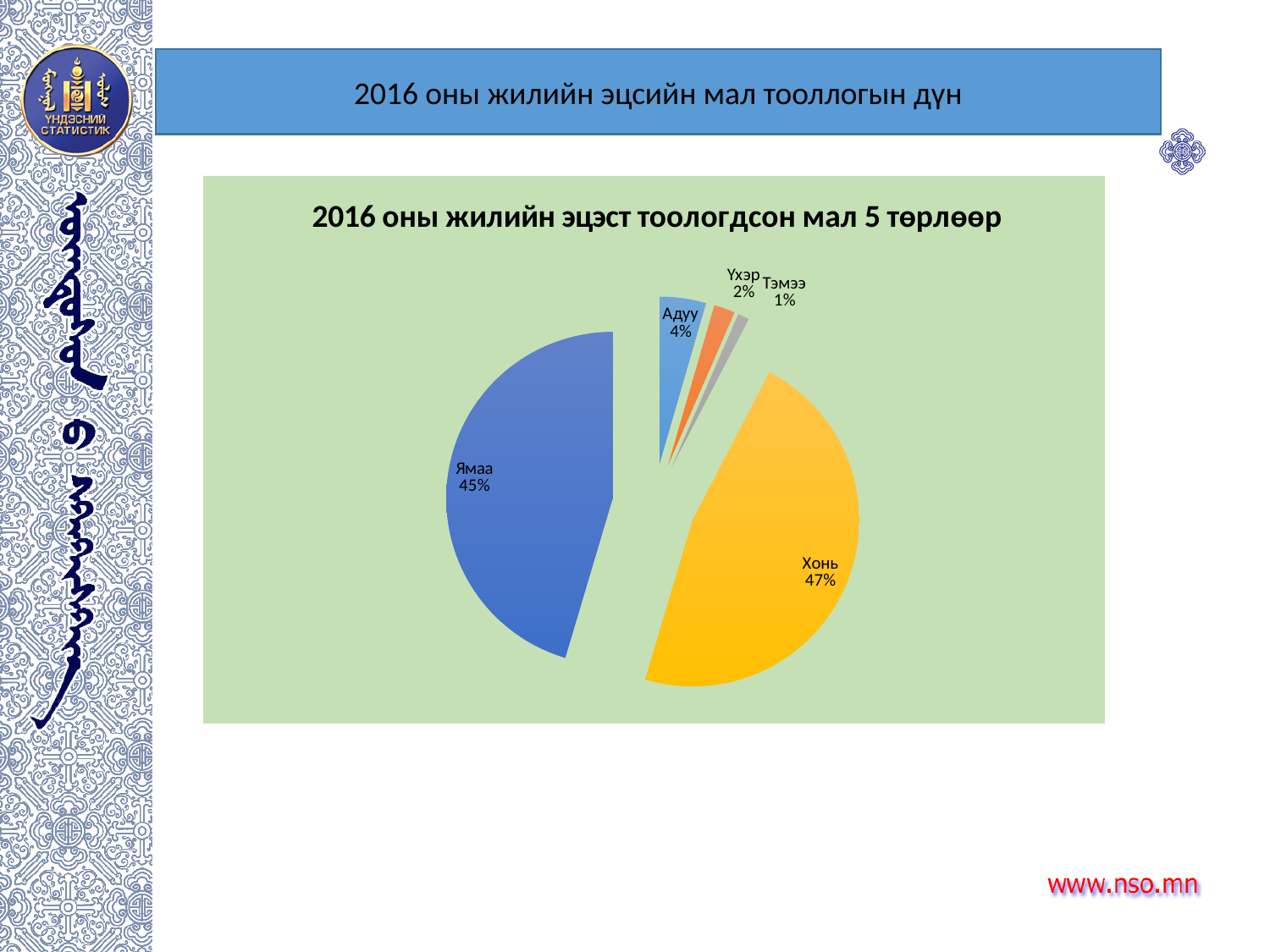
How many slices does the pie chart have? 5 What is the title of the chart? 2016 оны жилийн эцэст тоологдсон мал 5 төрлөөр What share of the pie does Ямаа have? 45% Which category has the largest slice of the pie? Хонь Which category has the smallest slice of the pie? Тэмээ Which is larger, the share for Адуу or the share for Үхэр? Адуу What share of the pie does Тэмээ have? 1% What kind of chart is shown on the slide? pie chart What share of the pie does Үхэр have? 2% What is the difference in percentage points between Хонь and Ямаа? 2%